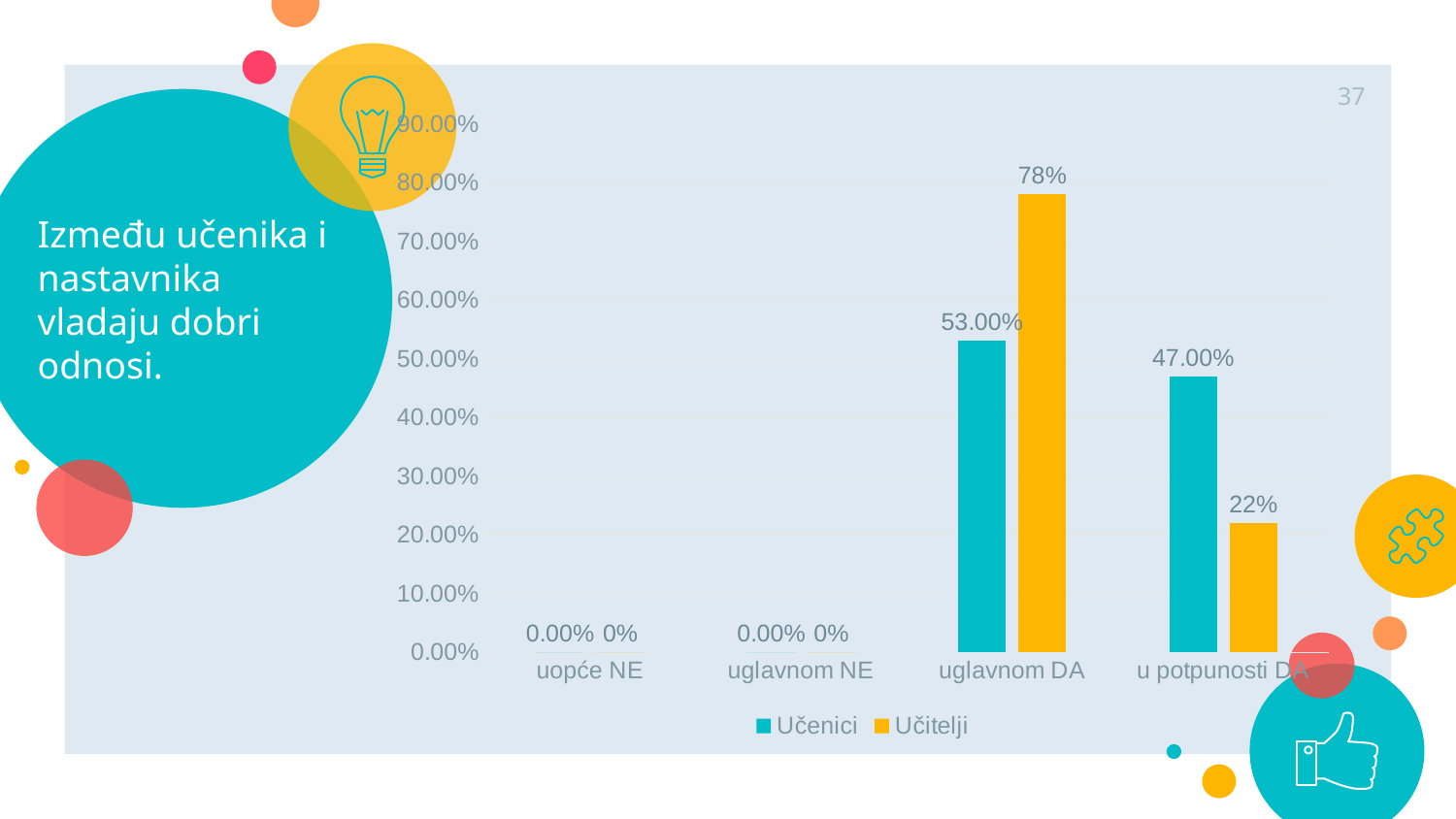
What kind of chart is shown on the slide? bar chart Which category has the highest value for Učitelji? uglavnom DA What is the value for Učitelji in the u potpunosti DA category? 22% What is the value for Učenici in the uglavnom DA category? 53.00% In the u potpunosti DA category, which series has the larger value, Učenici or Učitelji? Učenici What is the value for Učenici in the u potpunosti DA category? 47.00% What is the value for Učitelji in the uglavnom DA category? 78% Which category has the highest value for Učenici? uglavnom DA How many categories are shown on the x axis? 4 How many series does the legend list? 2 What is the difference between the Učitelji values for uglavnom DA and u potpunosti DA? 56% What is the difference between the Učenici values for uglavnom DA and u potpunosti DA? 6.00%